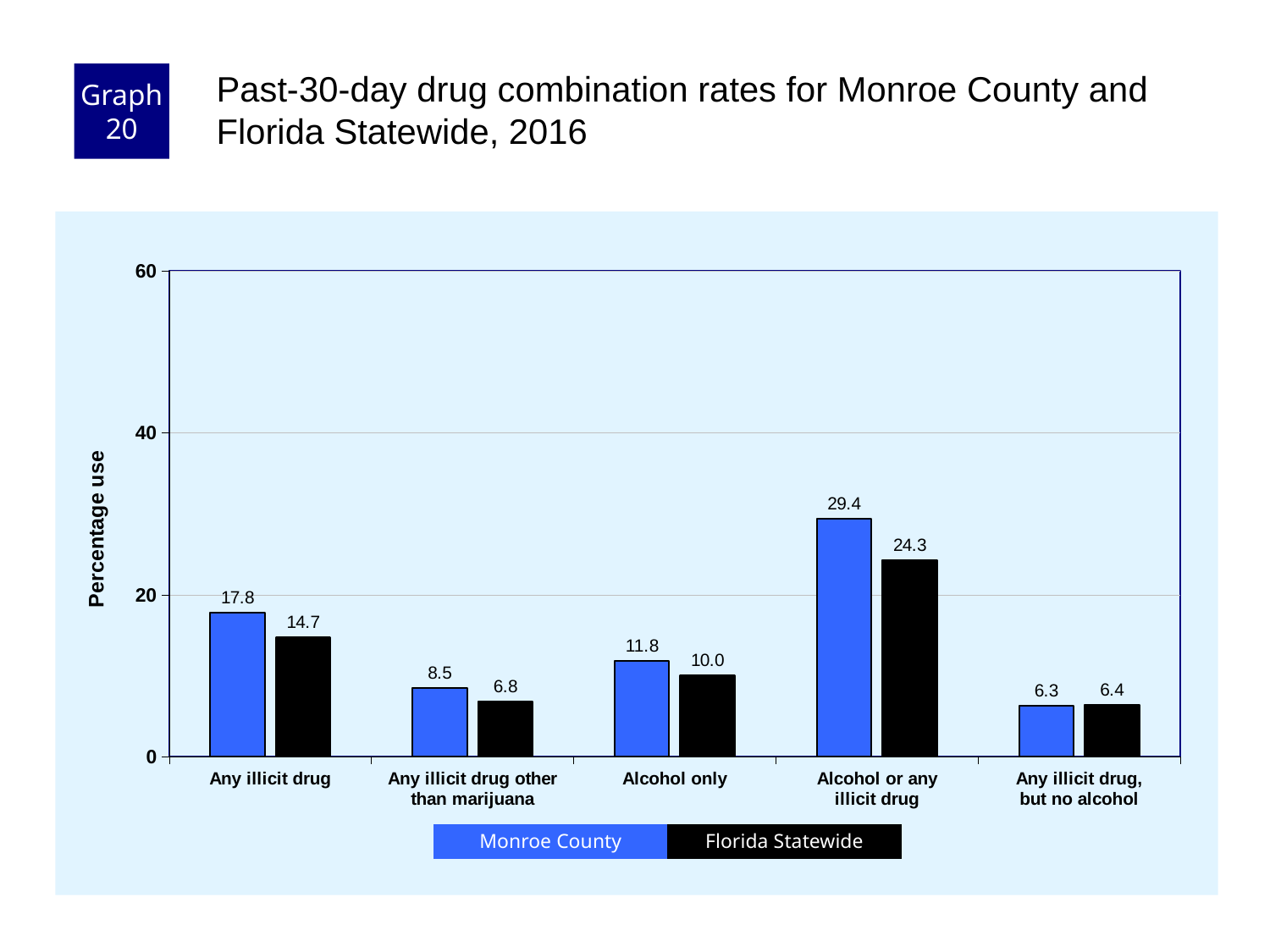
Which category has the highest Monroe County value? Alcohol or any illicit drug What is the Florida Statewide value for Any illicit drug, but no alcohol? 6.4 What is the Florida Statewide value for Alcohol only? 10.0 How many series does the legend list? 2 Which category has the lowest Florida Statewide value? Any illicit drug, but no alcohol What kind of chart is shown on the slide? bar chart How many categories are shown on the x axis? 5 Which is larger for Any illicit drug: the Monroe County value or the Florida Statewide value? Monroe County What is the Monroe County value for Any illicit drug? 17.8 What is the difference between the Monroe County and Florida Statewide values for Alcohol or any illicit drug? 5.1 Is the Monroe County value for Alcohol or any illicit drug greater or less than 20? greater What is the difference between the Monroe County and Florida Statewide values for Any illicit drug other than marijuana? 1.7